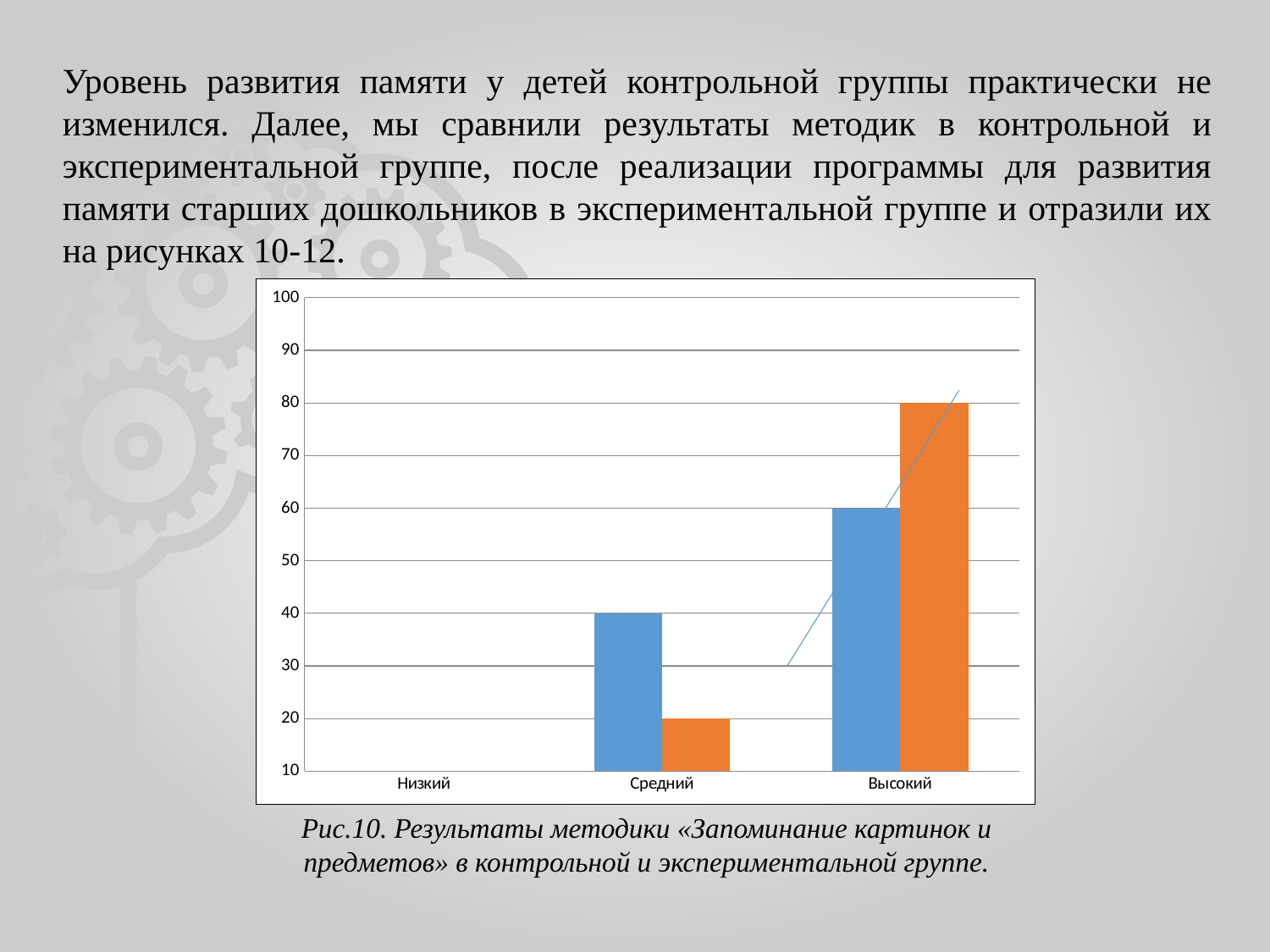
What is the difference between the orange bar and the blue bar for the category Высокий? 20 What kind of chart is shown on the slide? bar chart What is the value of the orange bar for the category Высокий? 80 What is the value of the blue bar for the category Высокий? 60 Which of the two bars is larger for the category Средний, the blue one or the orange one? blue What is the value of the orange bar for the category Средний? 20 Which category has the highest orange bar? Высокий What is the value of the blue bar for the category Средний? 40 What is the figure caption below the chart? Рис.10. Результаты методики «Запоминание картинок и предметов» в контрольной и экспериментальной группе. How many categories are shown on the x axis of the chart? 3 What is the difference between the blue bars for Высокий and Средний? 20 Which of the two bars is larger for the category Высокий, the blue one or the orange one? orange